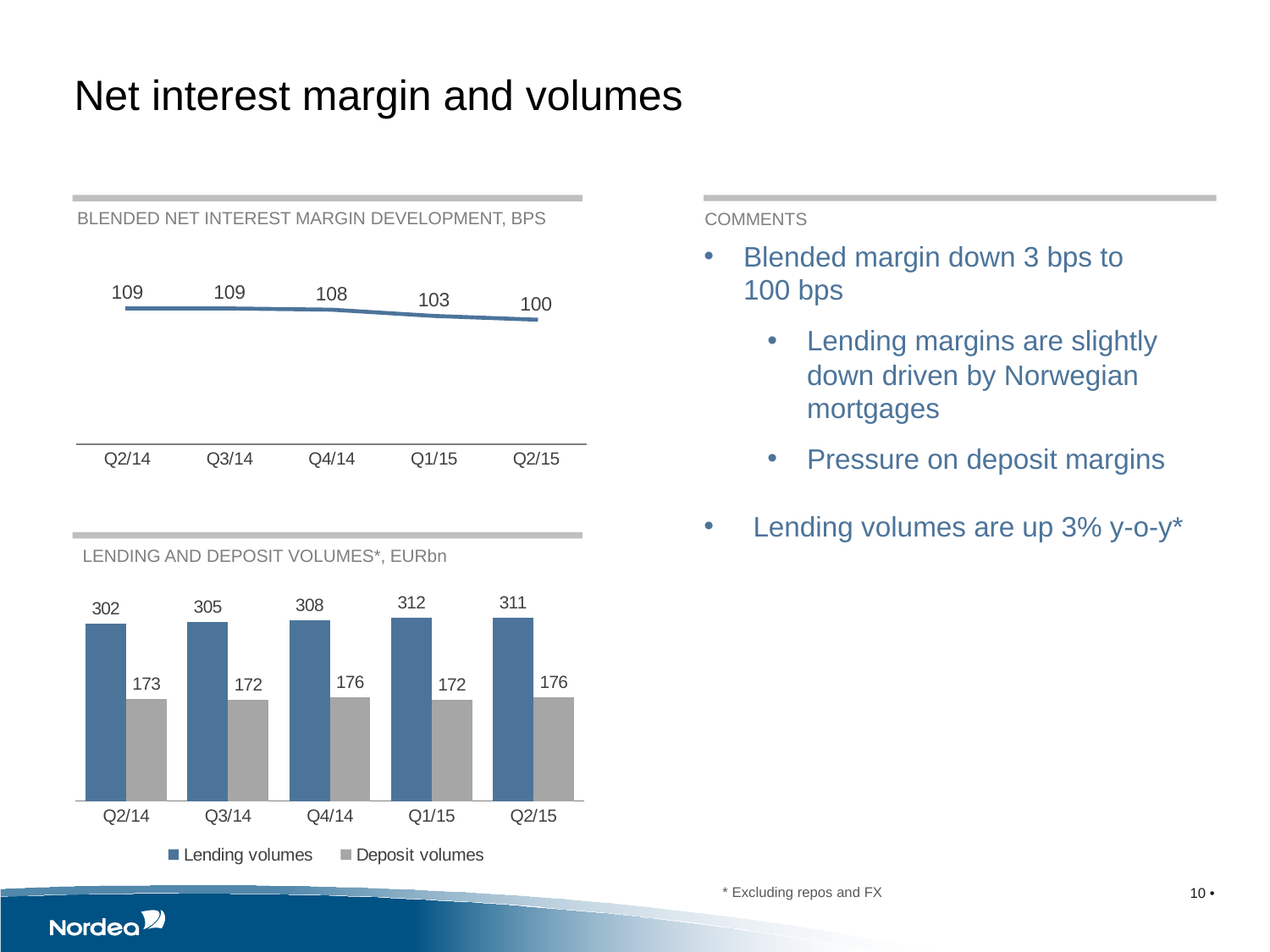
In the 'Blended net interest margin development, bps' chart, do the values rise or fall from Q2/14 to Q2/15? Fall In the 'Blended net interest margin development, bps' chart, what kind of chart is shown? Line chart In the 'Lending and deposit volumes, EURbn' chart, what kind of chart is shown? Bar chart In the 'Lending and deposit volumes, EURbn' chart, which quarter has the highest lending volume? Q1/15 In the 'Blended net interest margin development, bps' chart, what is the value for Q2/15? 100 In the 'Lending and deposit volumes, EURbn' chart, what is the difference between lending and deposit volumes in Q2/15? 135 In the 'Lending and deposit volumes, EURbn' chart, what is the lending volume for Q1/15? 312 In the 'Blended net interest margin development, bps' chart, what is the difference between the Q4/14 and Q1/15 values? 5 In the 'Lending and deposit volumes, EURbn' chart, which quarter has the lowest lending volume? Q2/14 In the 'Lending and deposit volumes, EURbn' chart, how many series does the legend list? 2 In the 'Blended net interest margin development, bps' chart, how many quarters are plotted? 5 In the 'Lending and deposit volumes, EURbn' chart, what is the deposit volume for Q3/14? 172